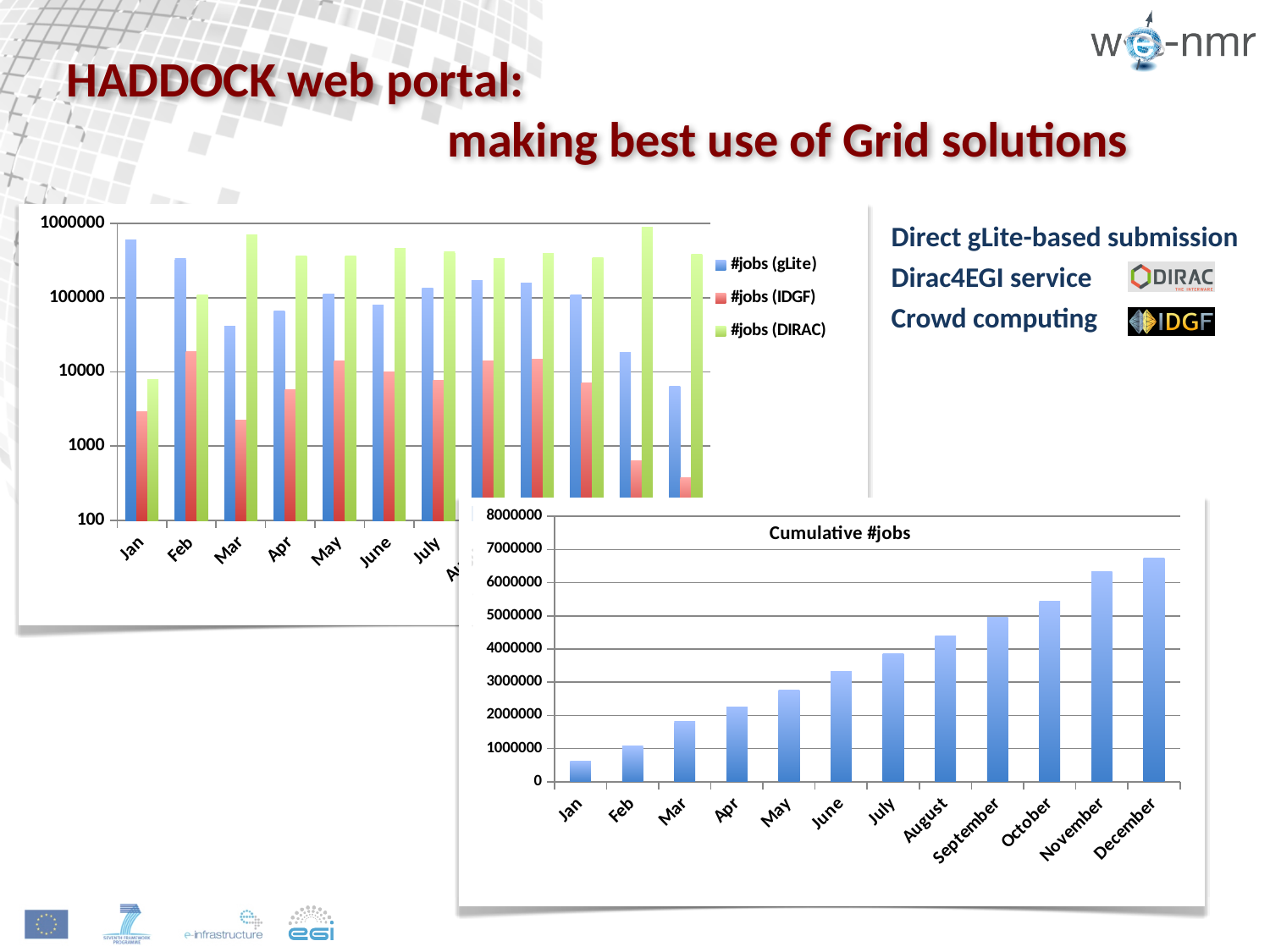
In the top-left monthly jobs chart, is the value for #jobs (DIRAC) in Jan greater or less than 10000? less In the 'Cumulative #jobs' chart, is the value for December greater or less than 6000000? greater How many series does the legend of the top-left monthly jobs chart list? 3 What are the three series named in the legend of the top-left monthly jobs chart? #jobs (gLite), #jobs (IDGF), #jobs (DIRAC) In the top-left monthly jobs chart, is the value for #jobs (gLite) in Jan greater or less than 100000? greater How many months are shown on the x axis of the 'Cumulative #jobs' chart? 12 In the 'Cumulative #jobs' chart, which month has the highest value? December What kind of chart is the 'Cumulative #jobs' chart? bar chart In the 'Cumulative #jobs' chart, do the values rise or fall from Jan to December? rise In the top-left monthly jobs chart, which is larger in Mar: #jobs (gLite) or #jobs (DIRAC)? #jobs (DIRAC) In the 'Cumulative #jobs' chart, which month has the lowest value? Jan